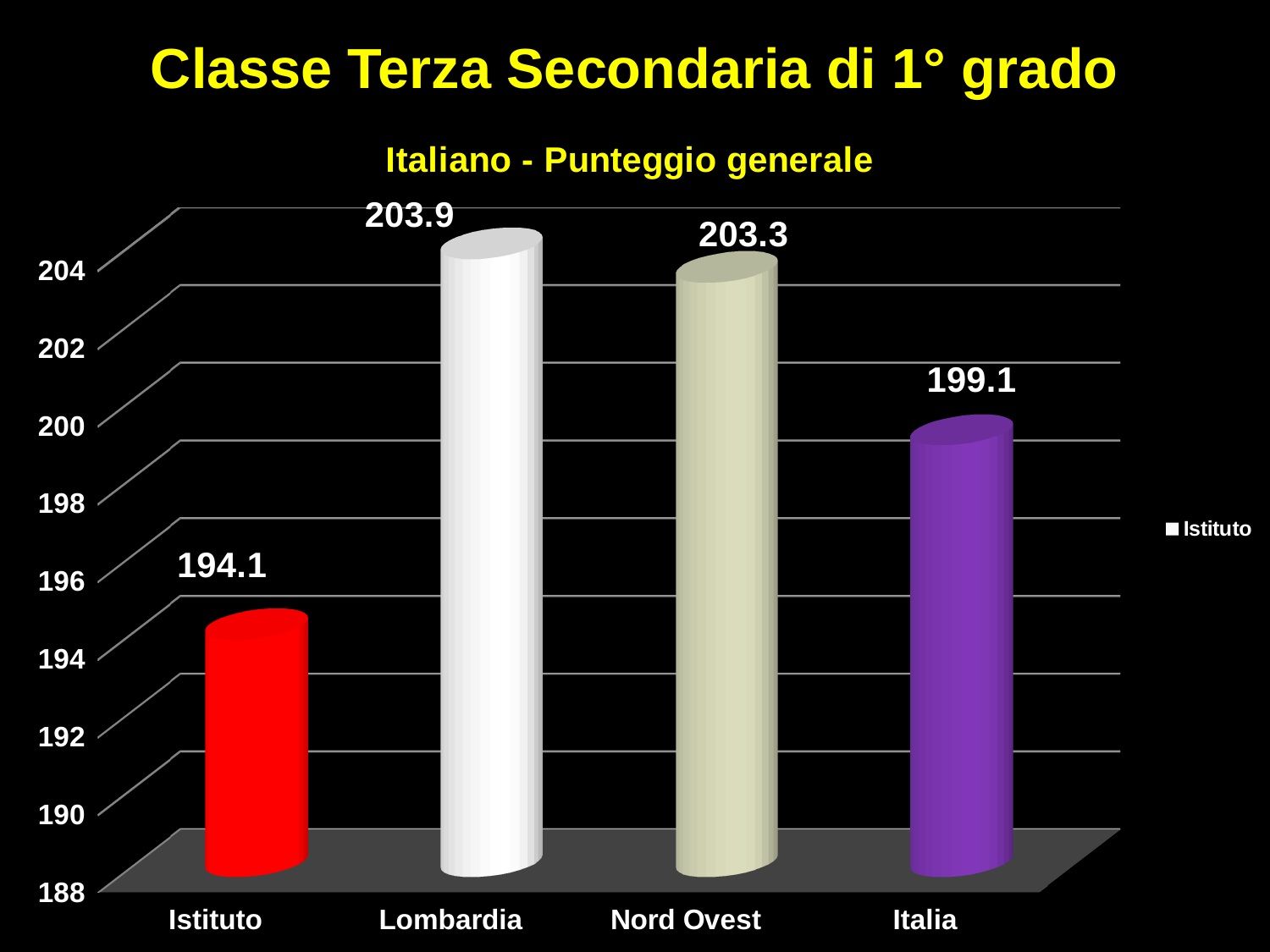
How many categories are shown on the x axis? 4 What is the difference between the values for Lombardia and Istituto? 9.8 What is the difference between the values for Italia and Istituto? 5.0 Which is larger, the value for Nord Ovest or the value for Italia? Nord Ovest Which category has the highest value? Lombardia What is the title of the chart? Italiano - Punteggio generale What is the value for Istituto? 194.1 What is the value for Nord Ovest? 203.3 Which category has the lowest value? Istituto What kind of chart is this? bar chart What is the value for Italia? 199.1 What is the value for Lombardia? 203.9